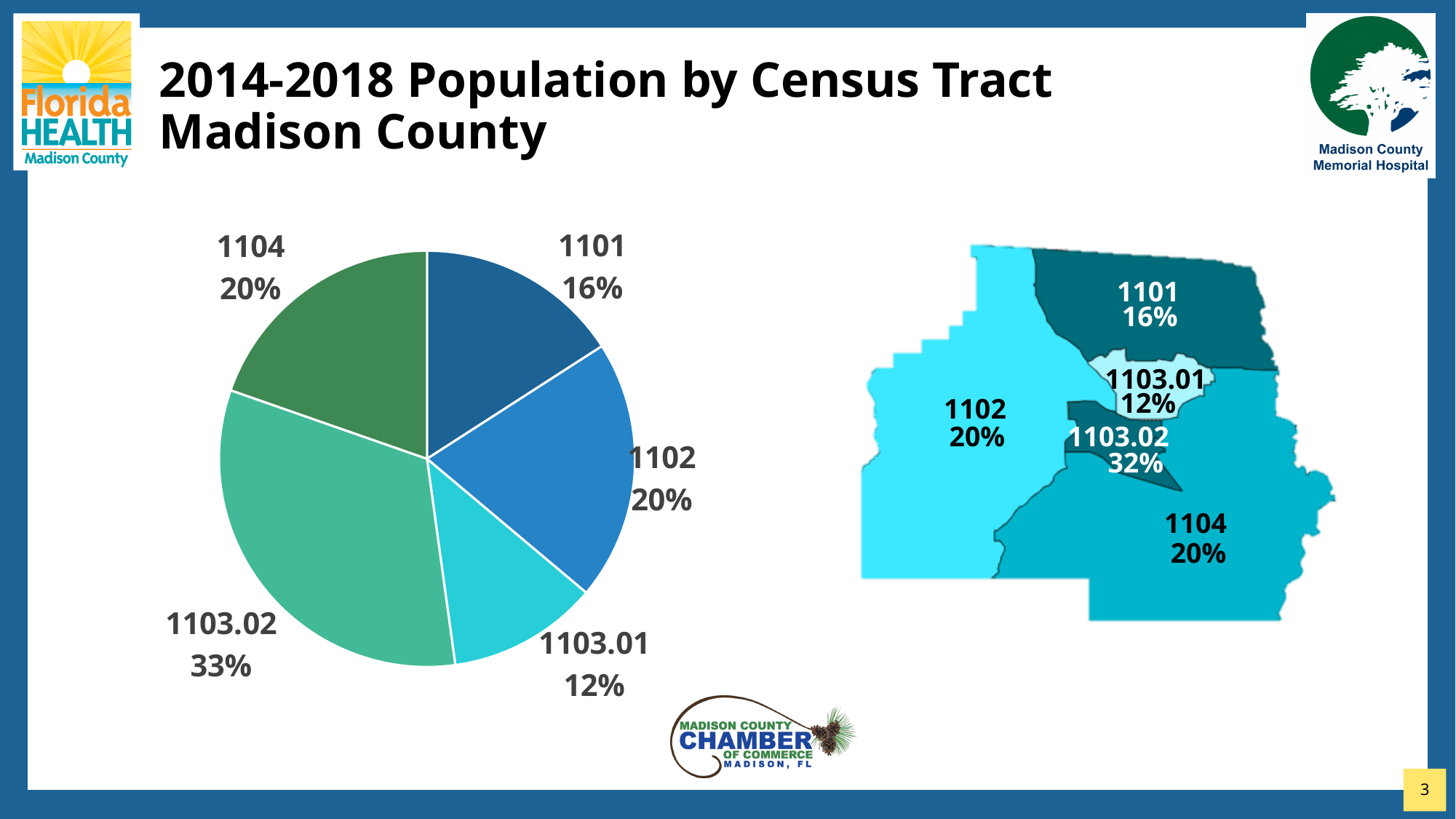
In the pie chart, how many percentage points larger is the share for tract 1103.02 than for tract 1101? 17 In the pie chart, what share of the population is in census tract 1101? 16% How many census tracts are shown as slices in the pie chart? 5 In the pie chart, what share of the population is in census tract 1103.01? 12% What type of chart is used on the left side of the slide to show population by census tract? Pie chart In the pie chart, which has the larger share, tract 1101 or tract 1104? 1104 In the pie chart, how many percentage points larger is the share for tract 1104 than for tract 1103.01? 8 What is the title of the slide containing the pie chart? 2014-2018 Population by Census Tract Madison County In the pie chart, what share of the population is in census tract 1102? 20% In the pie chart, which census tract has the largest share of the population? 1103.02 In the pie chart, which census tract has the smallest share of the population? 1103.01 In the pie chart, what share of the population is in census tract 1103.02? 33%